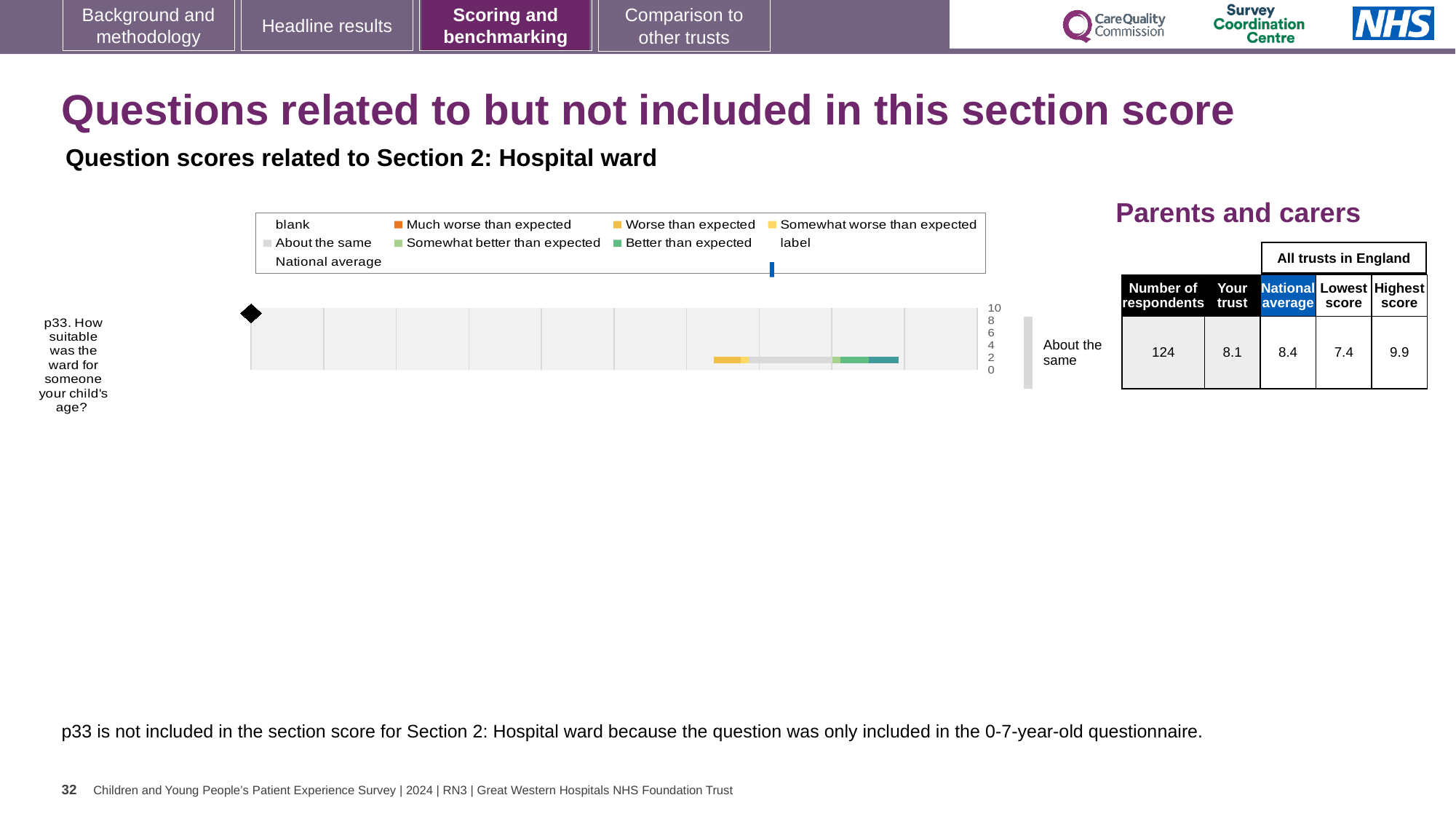
What is the difference between the highest and lowest scores for p33 across all trusts in England? 2.5 How many entries does the chart legend list? 9 Which question is plotted in the chart? p33. How suitable was the ward for someone your child's age? What is the national average score for p33 in the table beside the chart? 8.4 What is the 'Your trust' score for p33 in the table beside the chart? 8.1 What is the highest score among all trusts in England for p33? 9.9 Which is larger for p33, the 'Your trust' score or the national average? National average What kind of chart is used to show the p33 question score? bar chart What is the number of respondents for p33 in the table beside the chart? 124 What is the lowest score among all trusts in England for p33? 7.4 What benchmark category is shown next to the p33 bar? About the same How many questions are plotted in the chart? 1